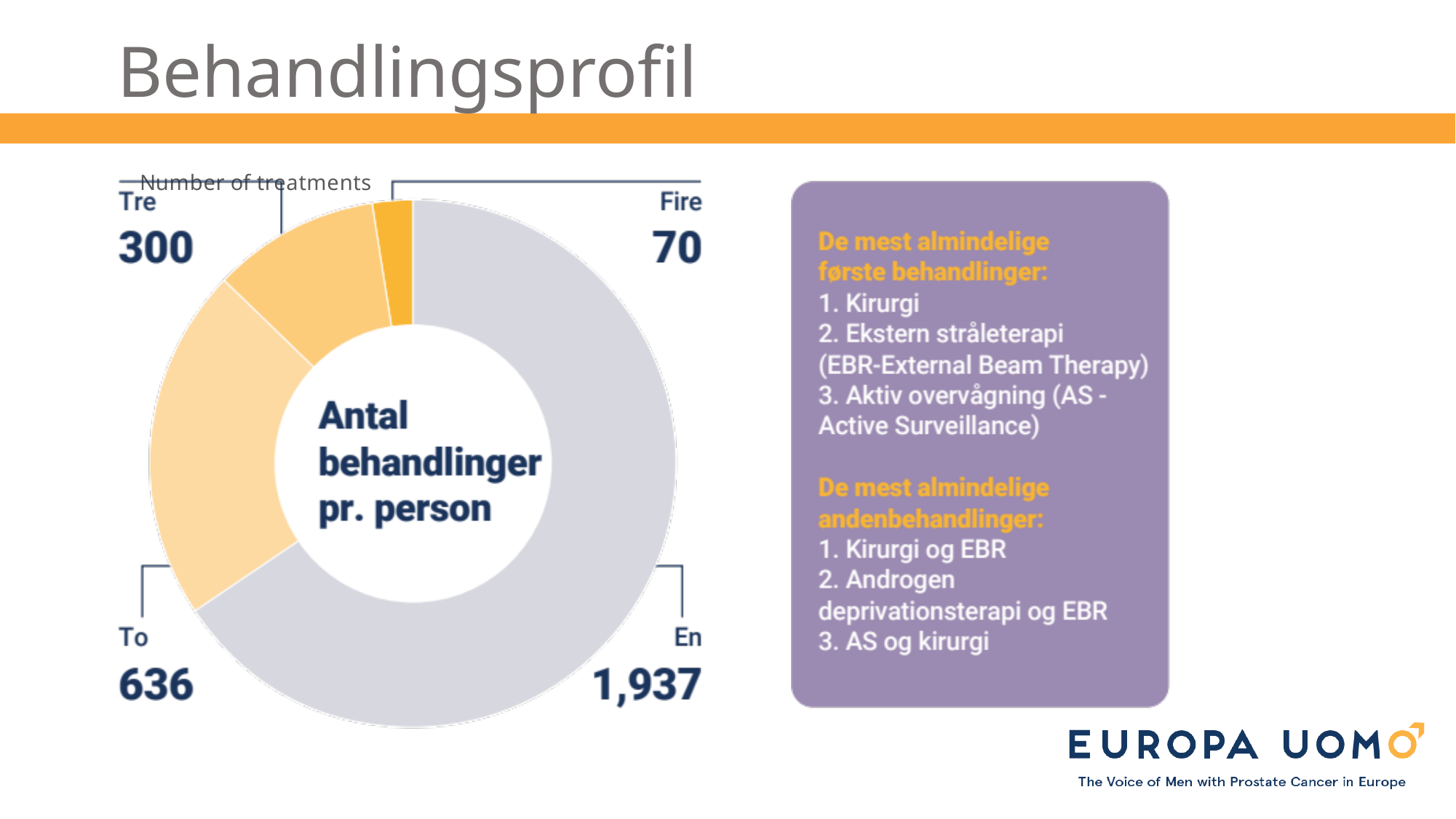
What is the difference between the values for "Tre" and "Fire" in the donut chart? 230 Which segment of the donut chart has the largest value? En What value is shown for the "Tre" segment of the donut chart? 300 What is the difference between the values for "En" and "To" in the donut chart? 1,301 What text is written in the centre of the donut chart? Antal behandlinger pr. person What kind of chart is shown on the slide? pie chart What value is shown for the "To" segment of the donut chart? 636 What value is shown for the "En" segment of the donut chart? 1,937 How many segments does the donut chart have? 4 What value is shown for the "Fire" segment of the donut chart? 70 Which is larger in the donut chart, the value for "To" or the value for "Tre"? To Which segment of the donut chart has the smallest value? Fire